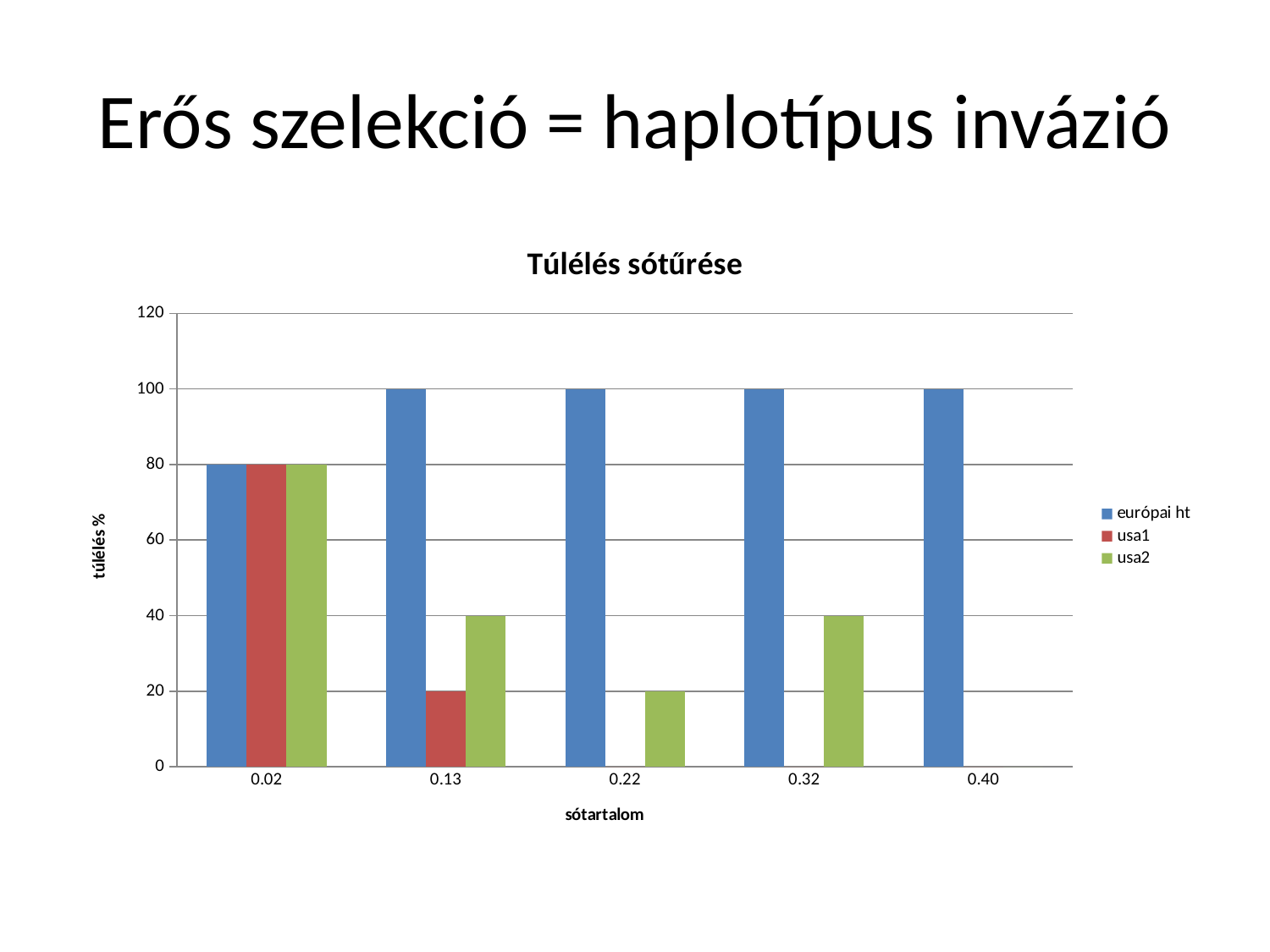
What kind of chart is shown on the slide? bar chart What is the túlélés % value for európai ht at sótartalom 0.13? 100 Which is larger at sótartalom 0.32, the európai ht value or the usa2 value? európai ht Is the usa2 value at sótartalom 0.13 greater or less than 60? less How many series does the legend list? 3 What is the difference between the európai ht and usa1 values at sótartalom 0.13? 80 What is the title of the chart? Túlélés sótűrése Which series has the lowest value at sótartalom 0.13? usa1 What is the túlélés % value for usa2 at sótartalom 0.22? 20 Which colour represents the usa2 series in the legend? green What is the túlélés % value for usa1 at sótartalom 0.02? 80 How many sótartalom categories are shown on the x axis? 5